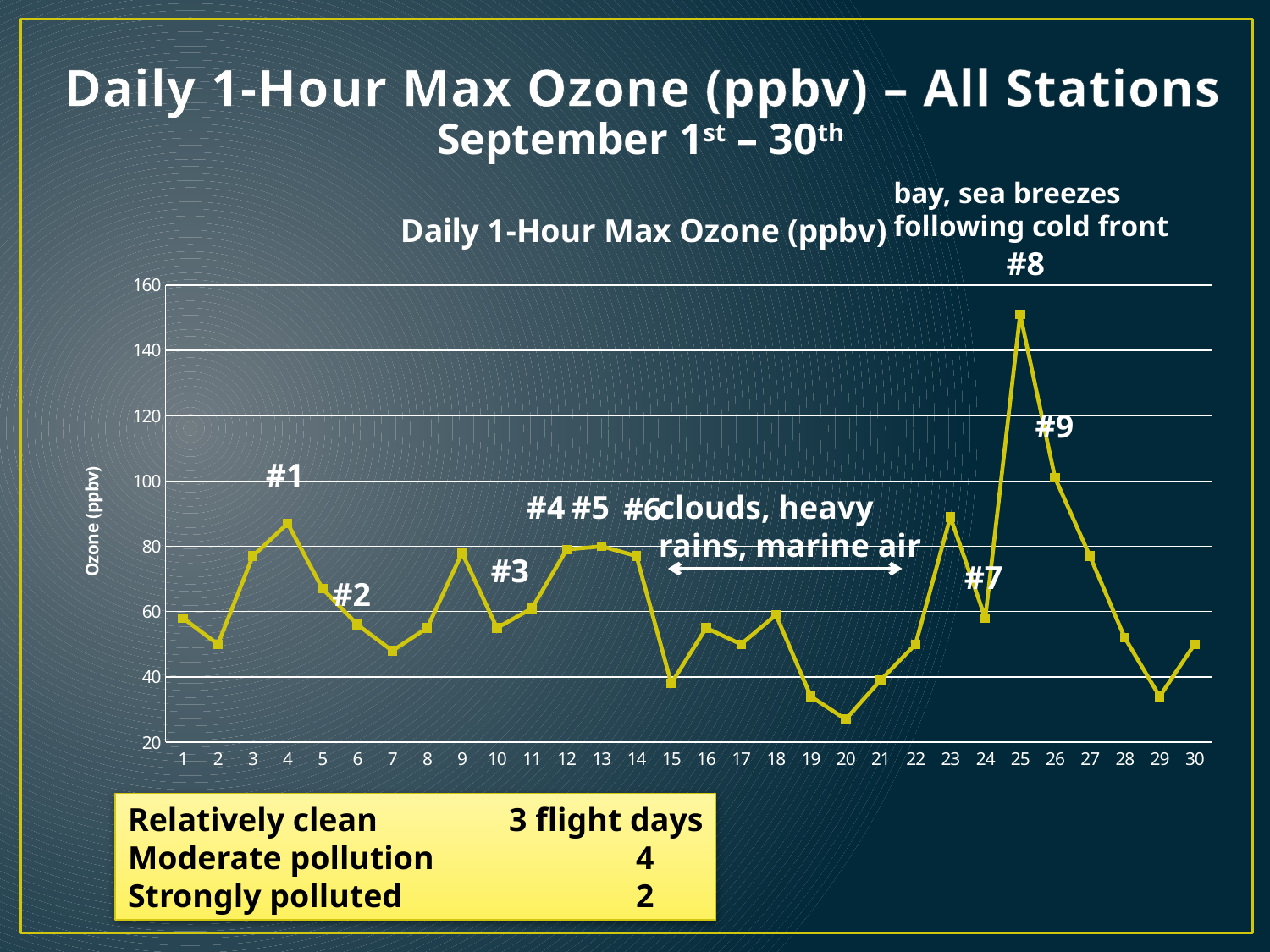
How many days are plotted on the x axis? 30 On which day is the daily 1-hour max ozone highest? 25 On which day is the daily 1-hour max ozone lowest? 20 Is the value for day 4 greater or less than 80? greater Is the value for day 25 greater or less than 140? greater What kind of chart is shown on the slide? line chart Which day has the larger value, day 25 or day 4? day 25 Do the values rise or fall from day 25 to day 29? fall What is the label on the y axis of the chart? Ozone (ppbv) Is the value for day 20 greater or less than 40? less Which flight number annotation is placed at the peak on day 25? #8